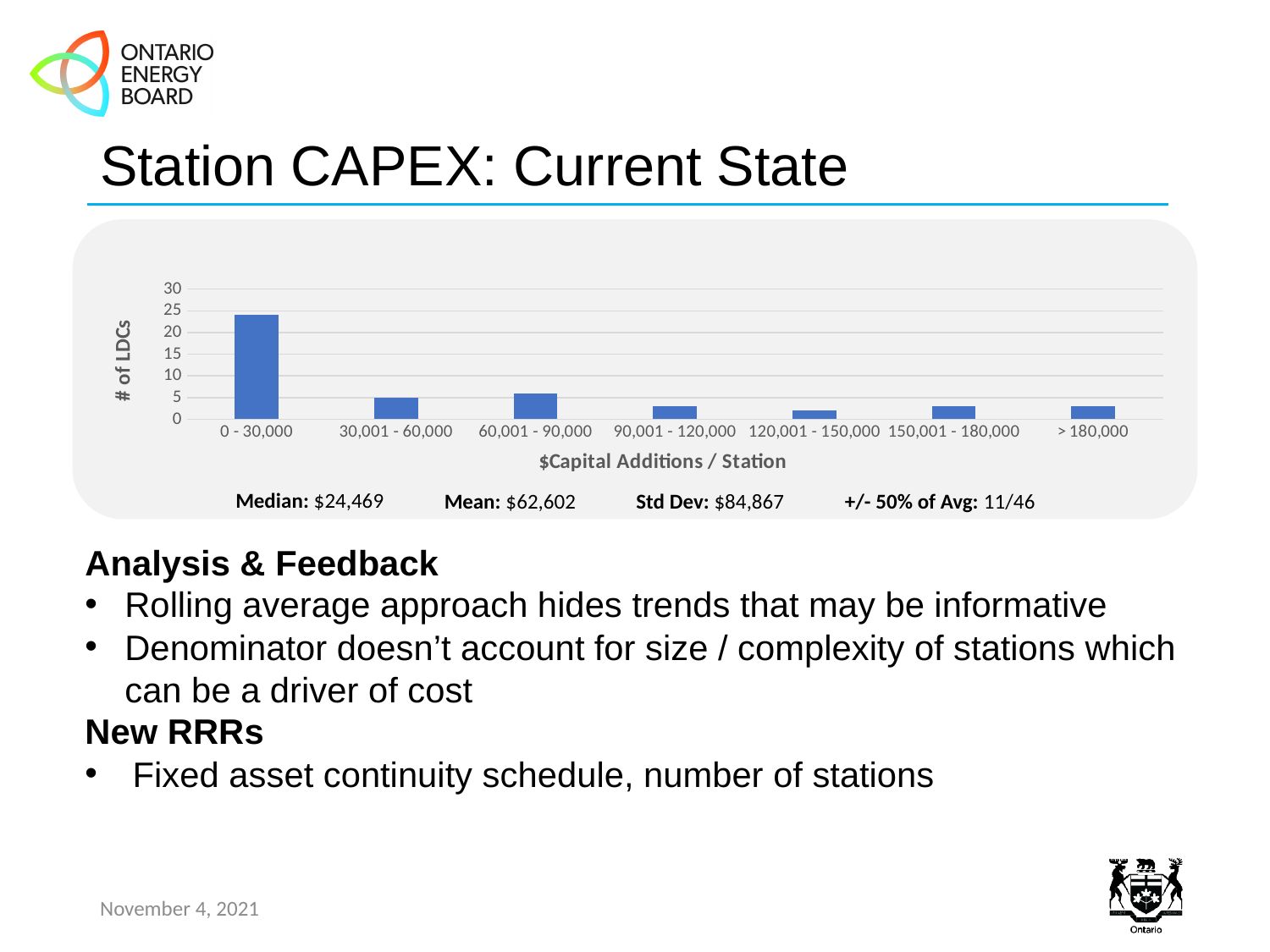
How many capital-additions-per-station categories are shown on the x axis? 7 Is the number of LDCs in the > 180,000 category greater or less than 5? less Which category has the highest number of LDCs? 0 - 30,000 What kind of chart is shown on the slide? bar chart What is the title of the y axis of the chart? # of LDCs What is the title of the x axis of the chart? $Capital Additions / Station Is the number of LDCs in the 60,001 - 90,000 category greater or less than 10? less Is the number of LDCs in the 90,001 - 120,000 category greater or less than 5? less Which category has more LDCs: 0 - 30,000 or 60,001 - 90,000? 0 - 30,000 Which category has more LDCs: 30,001 - 60,000 or 90,001 - 120,000? 30,001 - 60,000 Which category has the lowest number of LDCs? 120,001 - 150,000